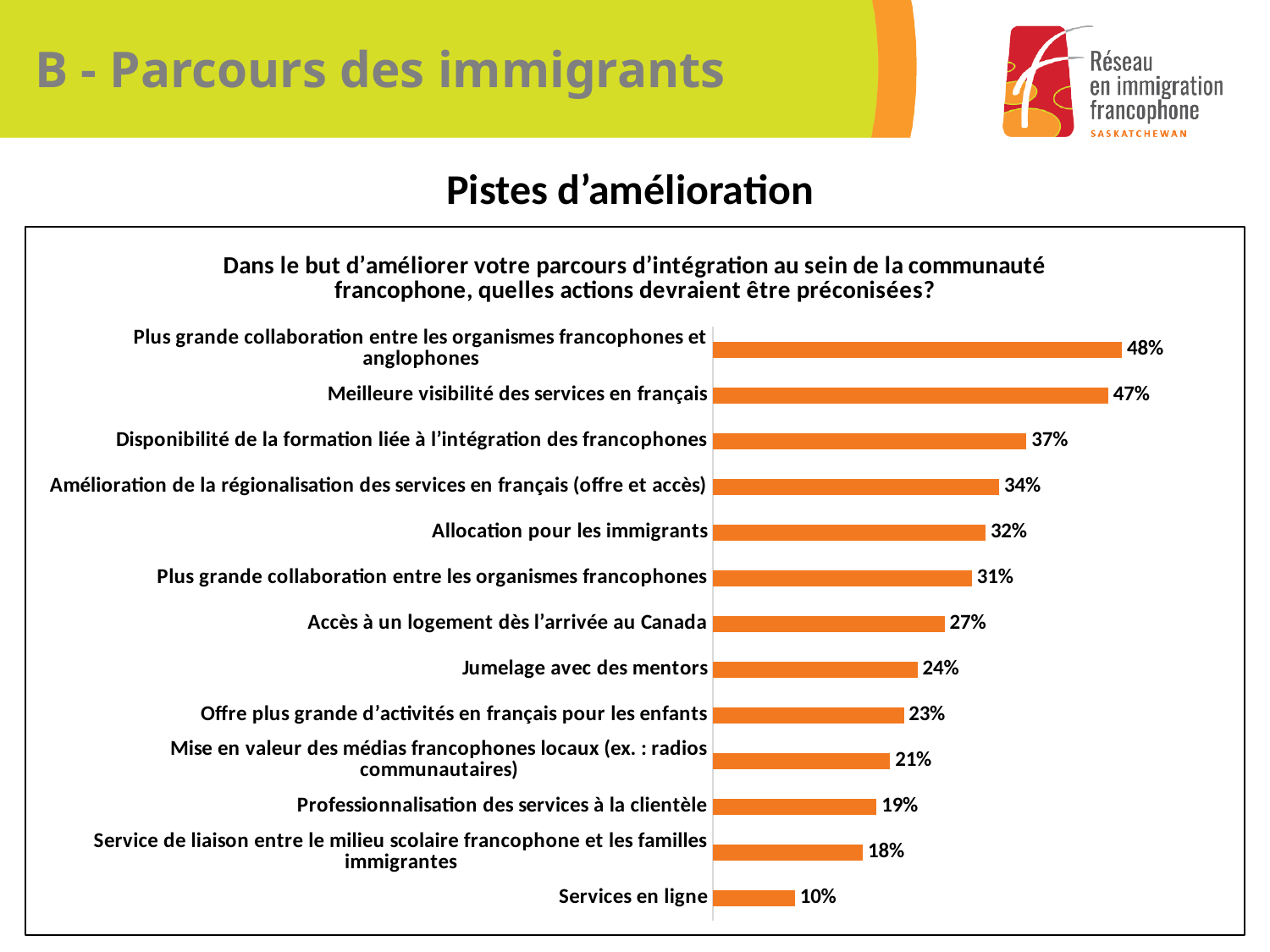
How many categories are shown in the chart? 13 Which category has the lowest value? Services en ligne What kind of chart is shown on the slide? Bar chart What is the difference between the highest and lowest values in the chart? 38% Which category has the highest value? Plus grande collaboration entre les organismes francophones et anglophones What is the difference between the values for "Disponibilité de la formation liée à l'intégration des francophones" and "Accès à un logement dès l'arrivée au Canada"? 10% What is the value for "Service de liaison entre le milieu scolaire francophone et les familles immigrantes"? 18% Which is larger: the value for "Professionnalisation des services à la clientèle" or the value for "Offre plus grande d'activités en français pour les enfants"? Offre plus grande d'activités en français pour les enfants What is the value for "Allocation pour les immigrants"? 32% What is the value for "Meilleure visibilité des services en français"? 47% What is the value for "Jumelage avec des mentors"? 24% What colour are the bars in the chart? Orange